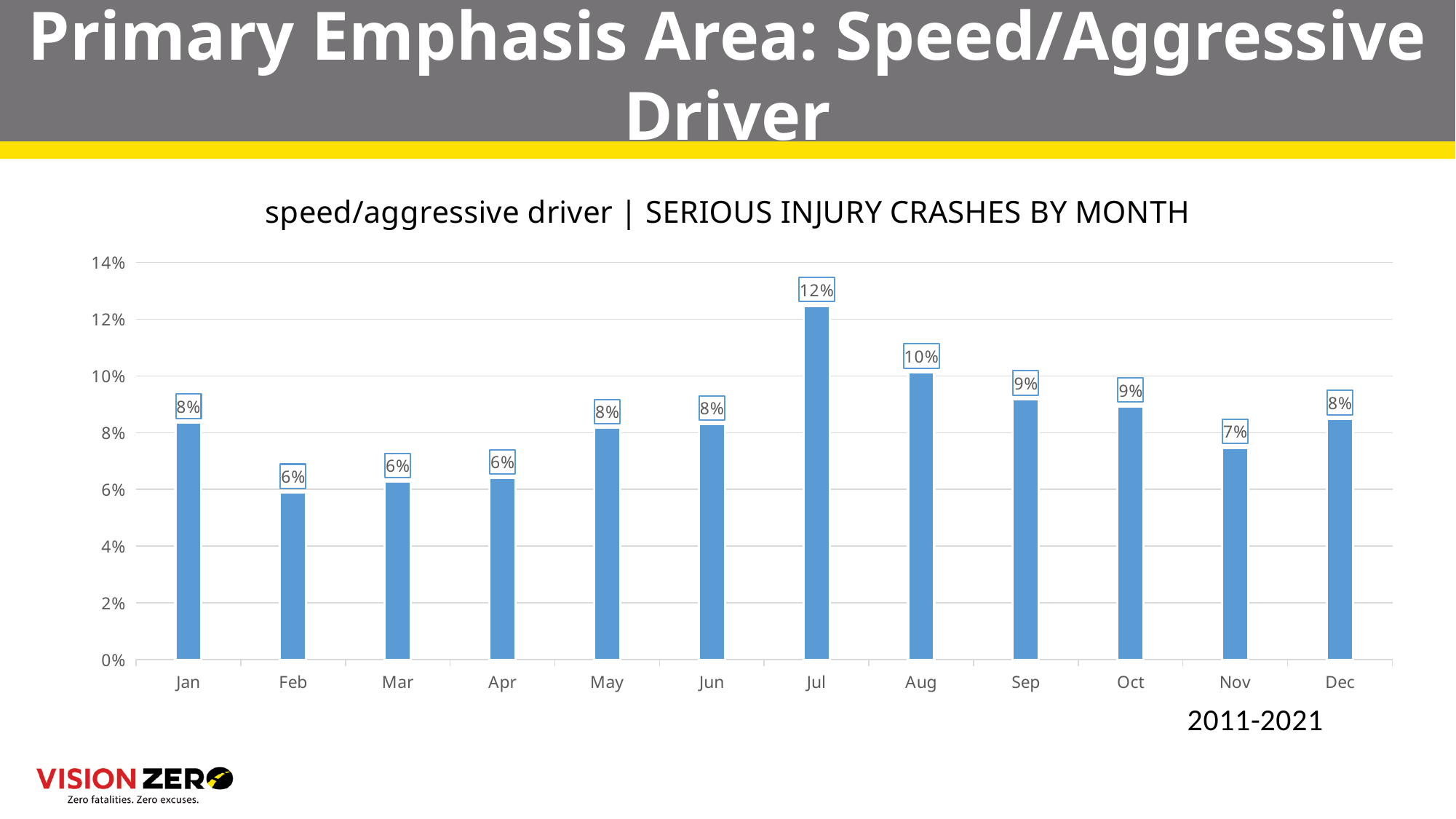
Which is larger, the value for Jul or the value for Nov? Jul What is the value for Nov? 7% What is the value for Feb? 6% Do the values rise or fall from Jul to Nov? fall How many months are shown on the x axis? 12 What is the difference between the values for Jul and Aug? 2% What kind of chart is shown on the slide? bar chart What is the value for Jul? 12% Is the value for Jul greater or less than 10%? greater What is the value for Aug? 10% Which month has the highest value? Jul Is the value for Feb greater or less than 8%? less